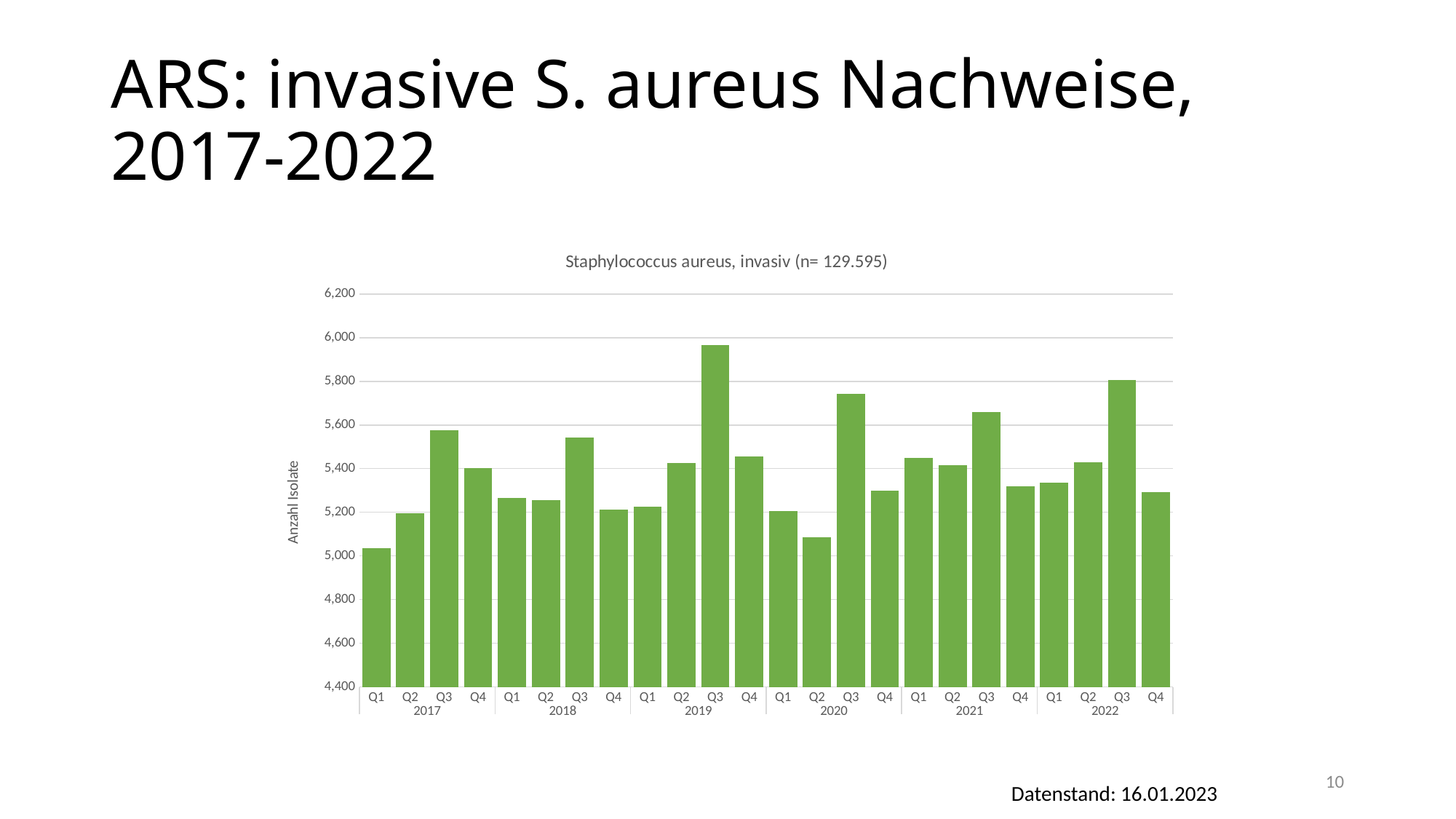
Is the value for Q1 2017 greater or less than 5,200? less What is the title printed above the chart? Staphylococcus aureus, invasiv (n= 129.595) Is the value for Q3 2022 greater or less than 5,600? greater Is the value for Q4 2022 greater or less than 5,400? less Which is larger, the value for Q1 2017 or the value for Q3 2017? Q3 2017 How many bars (quarters) are plotted in the chart? 24 Which quarter has the highest bar in the chart? Q3 2019 What is the label of the vertical axis? Anzahl Isolate Which is larger, the value for Q3 2019 or the value for Q3 2022? Q3 2019 What kind of chart is shown on the slide? bar chart